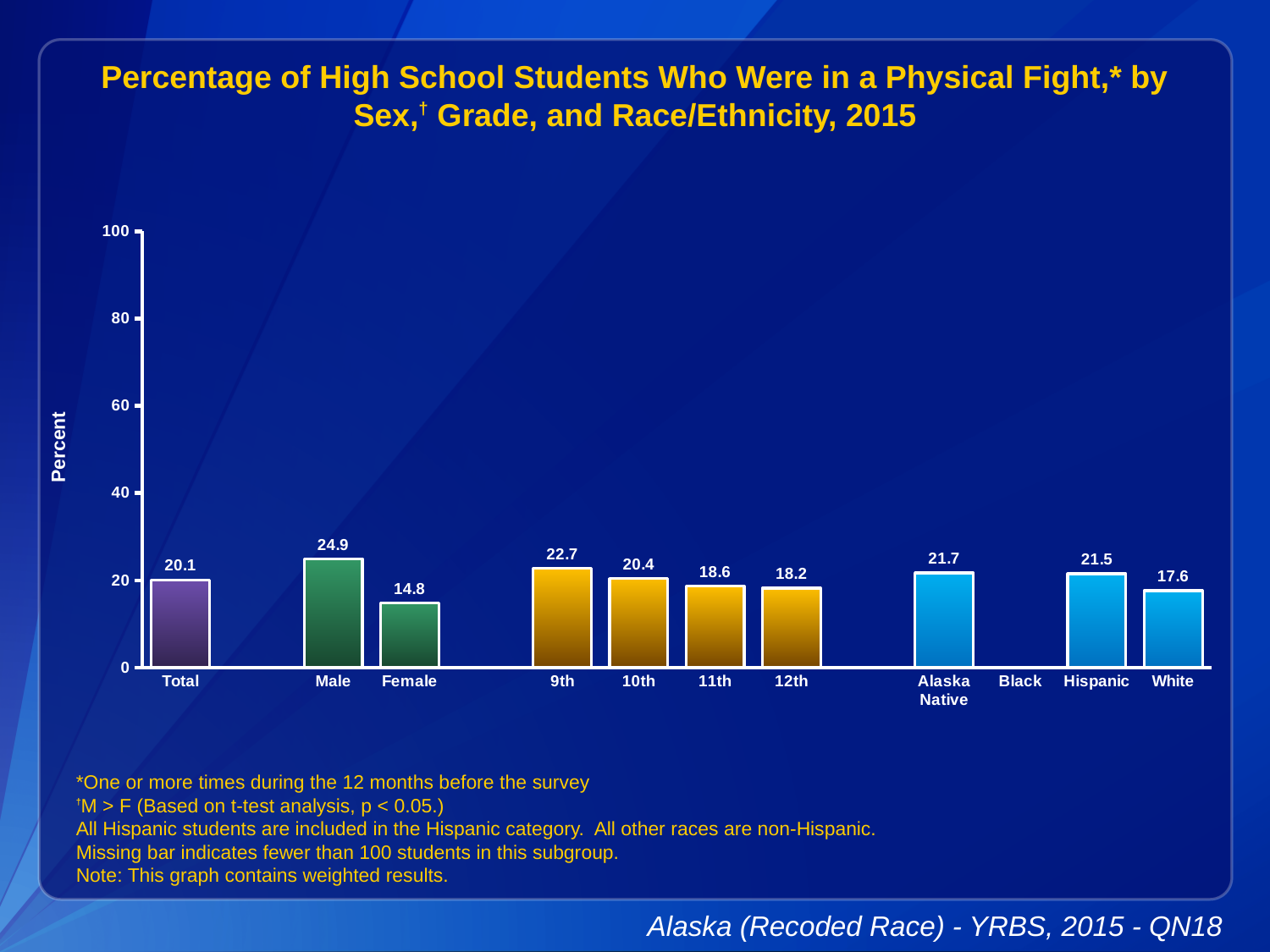
What is the value for 9th grade? 22.7 Which category has the highest value? Male What is the value for Female? 14.8 Which category has the lowest value among the bars shown? Female Which category label has no bar shown? Black How many bars are plotted on the chart? 11 What kind of chart is this? Bar chart What is the difference between the Male and Female values? 10.1 What is the value for Male? 24.9 Do the values rise or fall from 9th grade to 12th grade? Fall What is the value for Alaska Native? 21.7 Which is larger, the value for Hispanic or the value for White? Hispanic